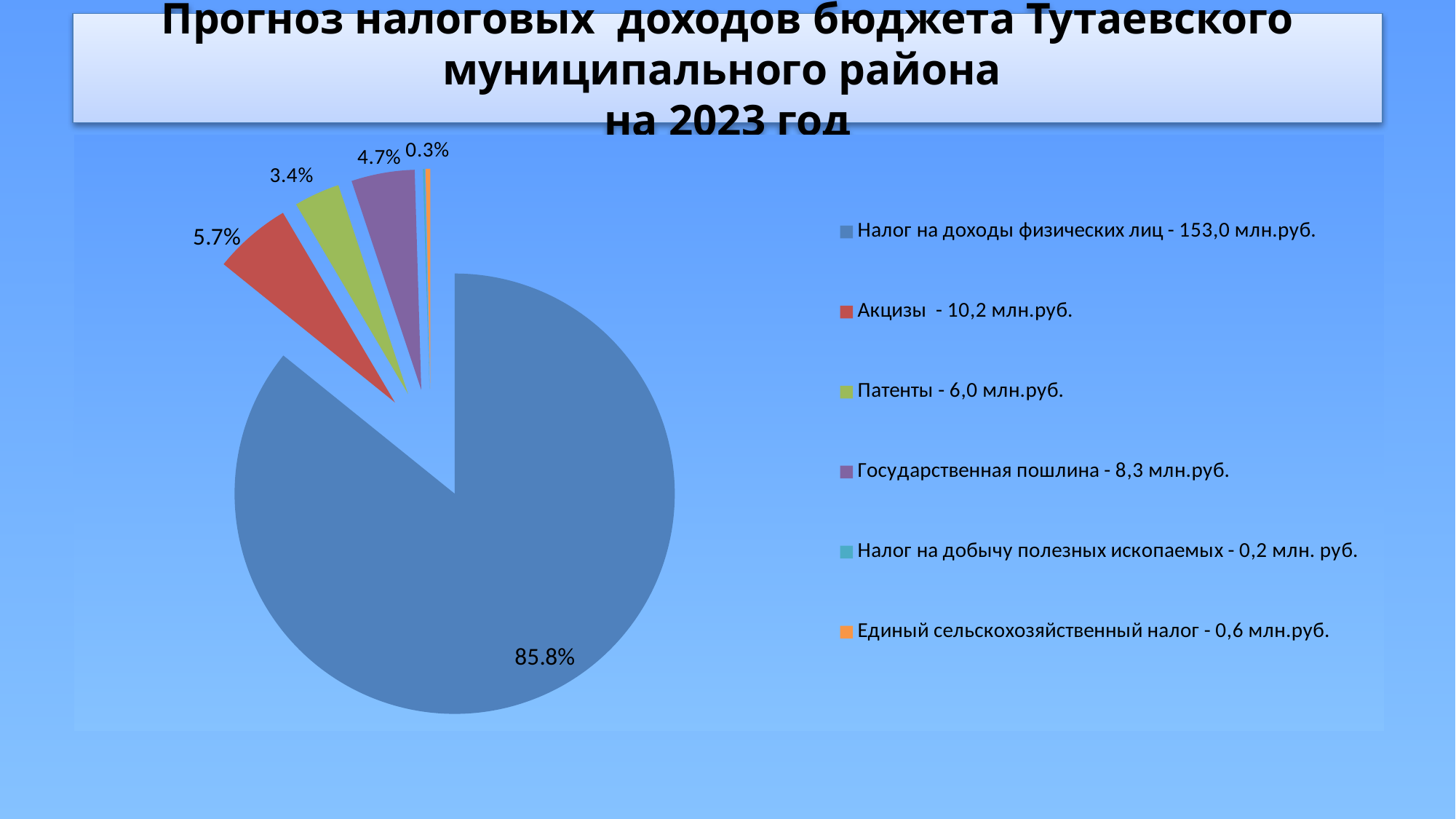
What is the difference between the legend values for Налог на доходы физических лиц and Акцизы? 142,8 млн.руб. What share of the pie does Патенты take? 3.4% Which is larger, the slice for Акцизы or the slice for Патенты? Акцизы What kind of chart is shown on the slide? pie chart What value does the legend give for Акцизы? 10,2 млн.руб. How many categories does the legend of the pie chart list? 6 What value does the legend give for Государственная пошлина? 8,3 млн.руб. What share of the pie does Государственная пошлина take? 4.7% What share of the pie does Акцизы take? 5.7% Which category has the smallest value in the legend? Налог на добычу полезных ископаемых Which category has the largest slice of the pie? Налог на доходы физических лиц